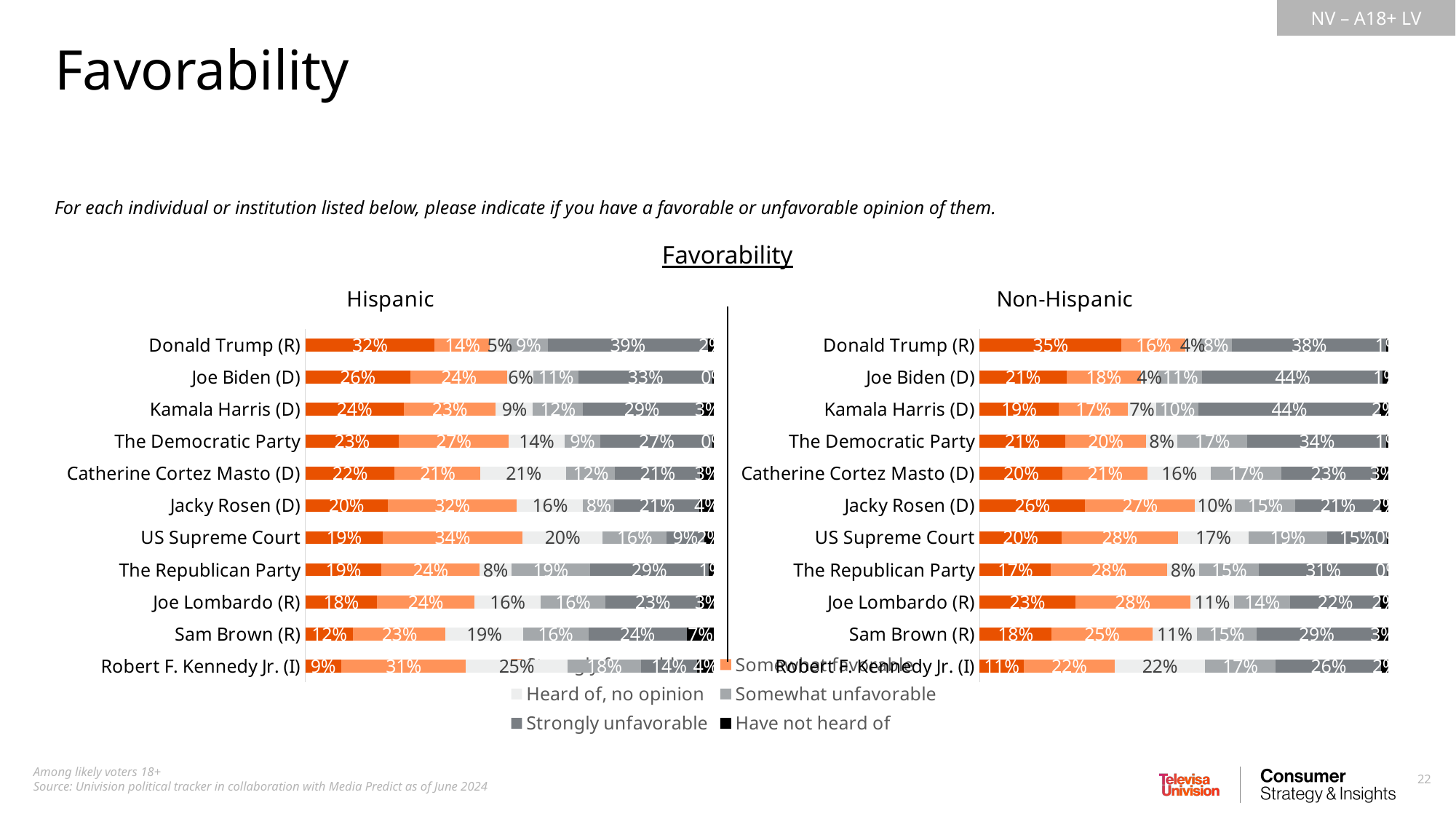
How many individuals or institutions are listed in the Non-Hispanic chart? 11 In the Hispanic chart, how many percentage points higher is Donald Trump's strongly favorable value than Joe Biden's? 6 percentage points In the Non-Hispanic chart, what percentage of respondents are strongly unfavorable toward Joe Biden (D)? 44% In the Hispanic chart, which individual or institution has the highest strongly favorable percentage? Donald Trump (R) In the Non-Hispanic chart, which individual or institution has the highest strongly favorable percentage? Donald Trump (R) In the Hispanic chart, which individual or institution has the lowest strongly favorable percentage? Robert F. Kennedy Jr. (I) In the Hispanic chart, what percentage of respondents are strongly favorable toward Donald Trump (R)? 32% In the Hispanic chart, what is the 'Heard of, no opinion' value for Robert F. Kennedy Jr. (I)? 25% In the Hispanic chart, which has a larger somewhat favorable value: Jacky Rosen (D) or the US Supreme Court? US Supreme Court What kind of chart is used on the slide for the Hispanic and Non-Hispanic favorability data? Stacked bar chart In the Non-Hispanic chart, what is the 'Have not heard of' value for Sam Brown (R)? 3% In the Non-Hispanic chart, what is the somewhat favorable value for the US Supreme Court? 28%